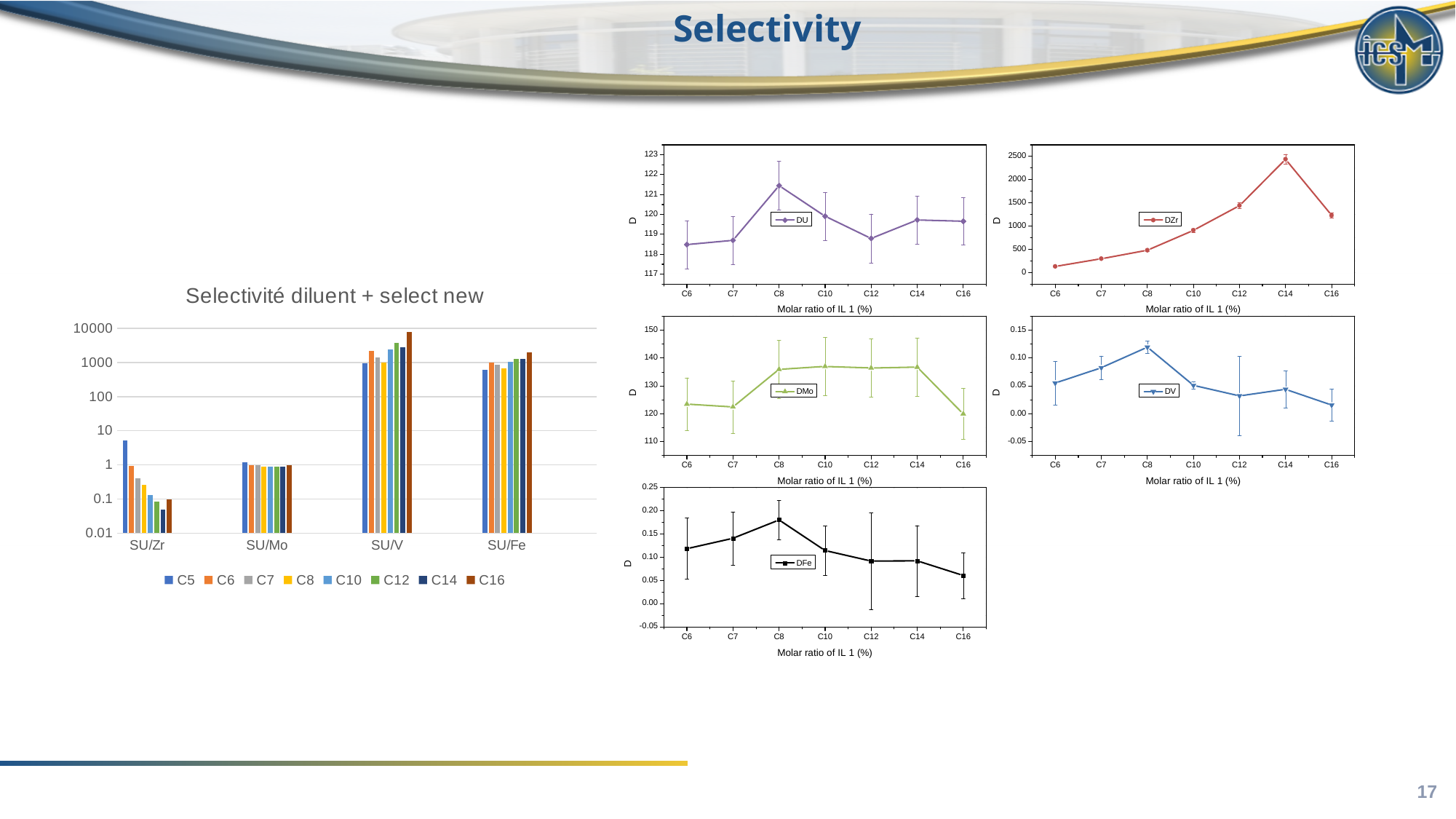
In the 'Selectivité diluent + select new' bar chart, is the C16 value for SU/V greater or less than 1000? greater What kind of chart is the 'Selectivité diluent + select new' chart? bar chart In the 'Selectivité diluent + select new' bar chart, which category has the highest bar? SU/V How many series does the legend of the 'Selectivité diluent + select new' bar chart list? 8 What is the x-axis label of the DMo line chart? Molar ratio of IL 1 (%) In the DU line chart, at which molar ratio is D highest? C8 In the DZr line chart, is the value at C14 greater or less than 2000? greater In the 'Selectivité diluent + select new' bar chart, is the C5 value for SU/Zr greater or less than 1? greater In the DZr line chart, at which molar ratio is D highest? C14 In the 'Selectivité diluent + select new' bar chart, which is larger: the C16 value for SU/V or the C16 value for SU/Fe? SU/V How many categories are shown on the x axis of the 'Selectivité diluent + select new' bar chart? 4